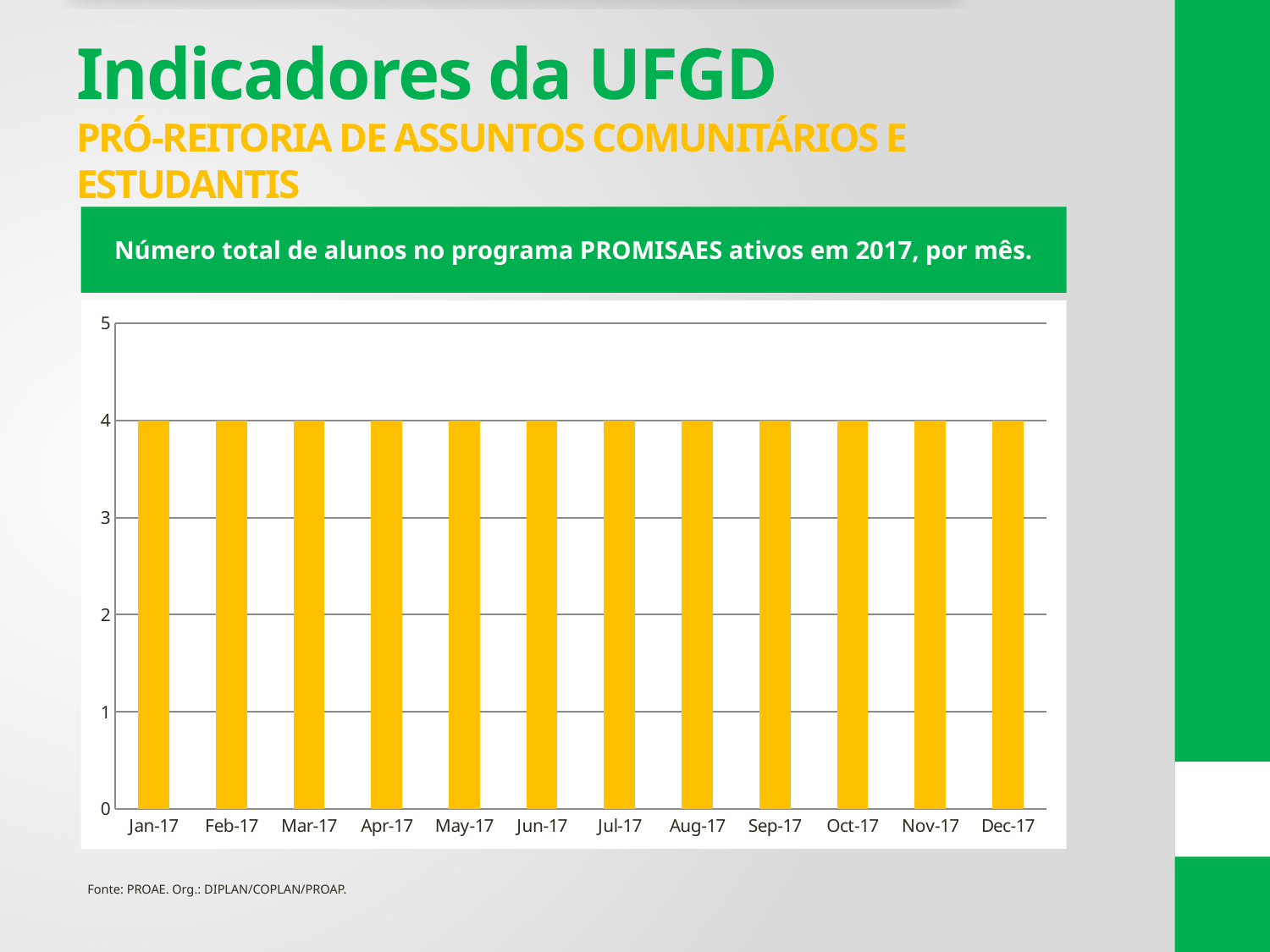
What is the title of the chart? Número total de alunos no programa PROMISAES ativos em 2017, por mês. Is the value for Oct-17 greater or less than 5? less Is the value for Mar-17 greater or less than 3? greater What is the highest value shown on the y axis? 5 What is the value for Dec-17? 4 What type of chart is shown on the slide? bar chart How many months are shown on the x axis of the chart? 12 What is the value for Jan-17? 4 Do the values rise, fall, or stay constant from Jan-17 to Dec-17? stay constant What is the value for Jul-17? 4 What is the difference between the values for Feb-17 and Nov-17? 0